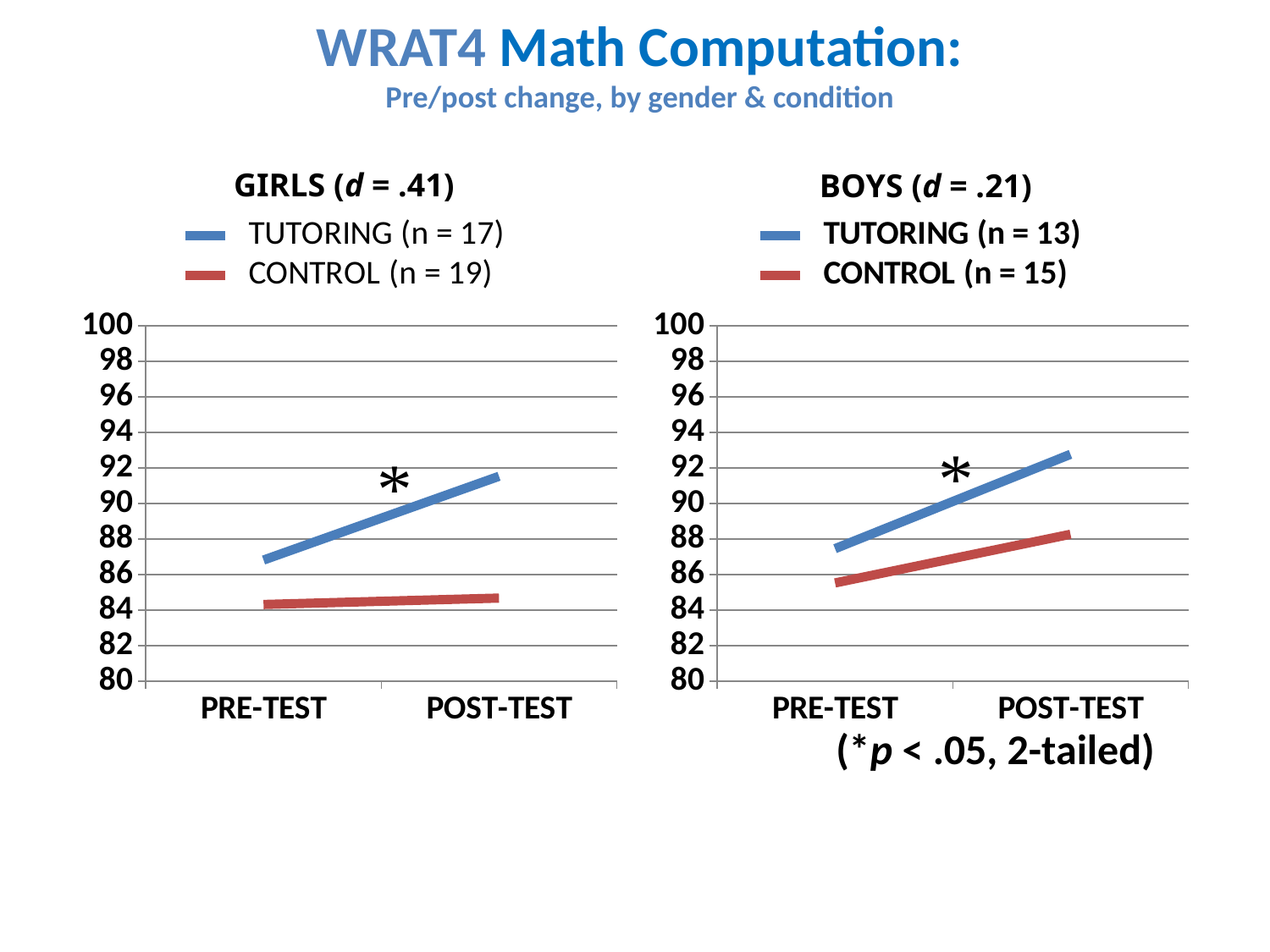
What kind of chart is the GIRLS chart? line chart In the GIRLS chart, is the CONTROL value at PRE-TEST greater or less than 86? less In the GIRLS chart, which series has the lower value at PRE-TEST, TUTORING or CONTROL? CONTROL In the BOYS chart, does the CONTROL line rise or fall from PRE-TEST to POST-TEST? rise What sample size does the legend of the BOYS chart give for the CONTROL series? n = 15 In the GIRLS chart, is the TUTORING value at POST-TEST greater or less than 90? greater How many points along the x axis does the GIRLS chart have? 2 How many series does the legend of the BOYS chart list? 2 In the GIRLS chart, does the TUTORING line rise or fall from PRE-TEST to POST-TEST? rise In the BOYS chart, is the TUTORING value at POST-TEST greater or less than 92? greater In the BOYS chart, which series has the higher value at POST-TEST, TUTORING or CONTROL? TUTORING